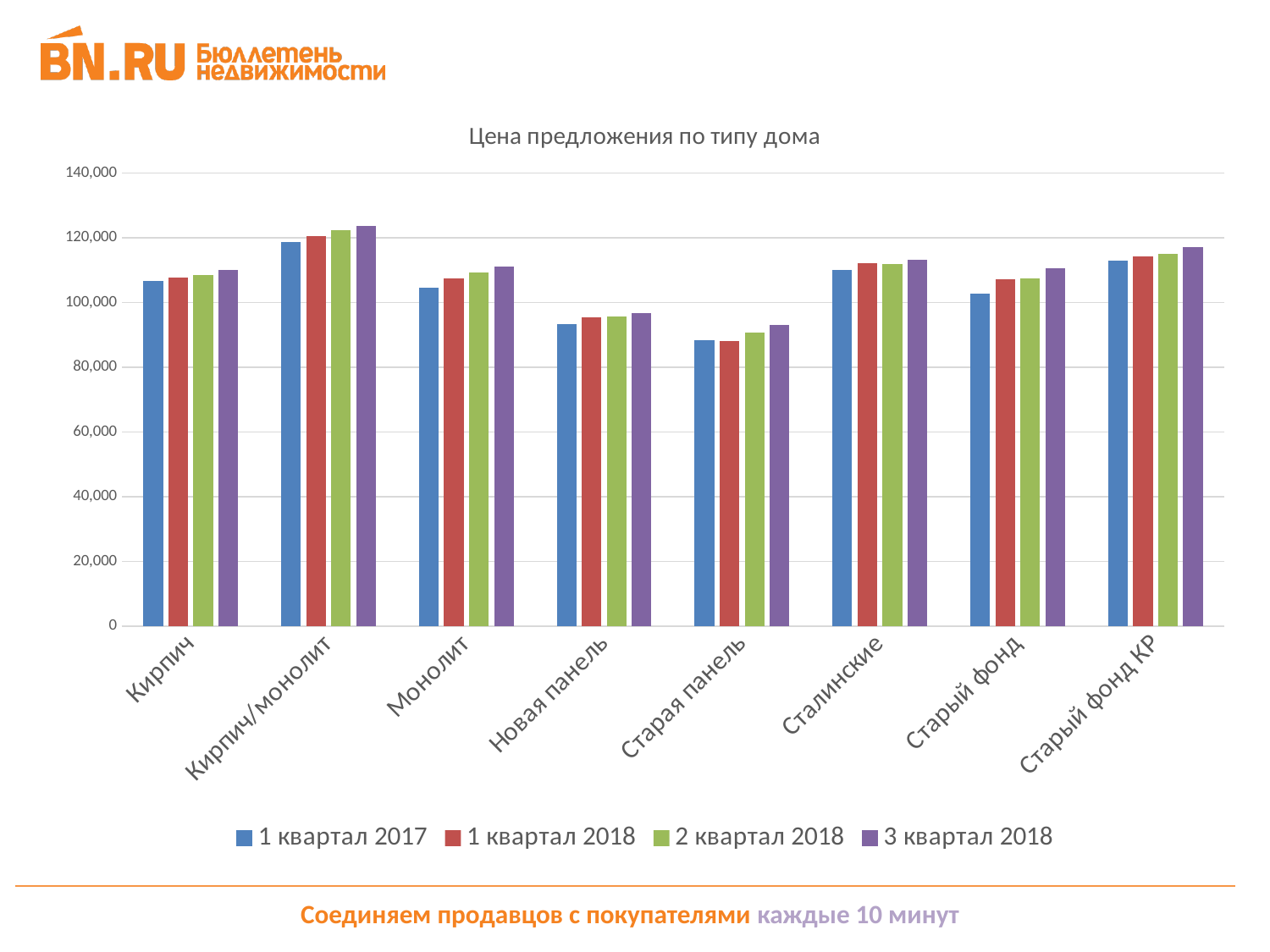
How many series does the legend list? 4 For 1 квартал 2017, which is larger: Кирпич/монолит or Монолит? Кирпич/монолит Is the value for Сталинские in 3 квартал 2018 greater or less than 100,000? greater What kind of chart is shown on the slide? bar chart Is the value for Старая панель in 1 квартал 2017 greater or less than 100,000? less Is the value for Новая панель in 3 квартал 2018 greater or less than 100,000? less What is the title of the chart? Цена предложения по типу дома For 3 квартал 2018, which is larger: Новая панель or Старая панель? Новая панель Which house type has the highest bar in the chart? Кирпич/монолит Which house type has the lowest bar in the chart? Старая панель How many house-type categories are shown on the x axis? 8